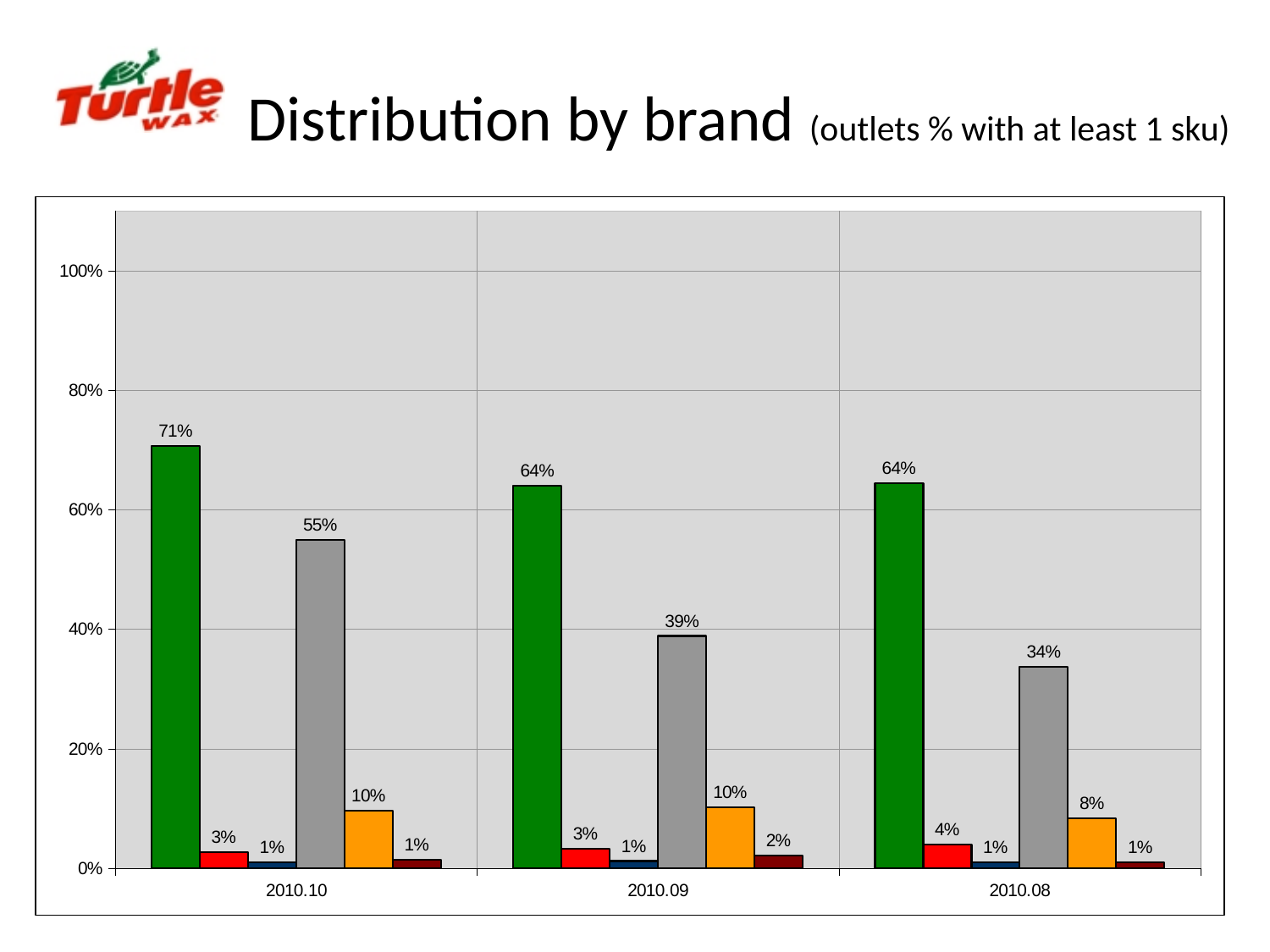
What is the difference between the green bar and the grey bar for 2010.10? 16% What is the value of the orange bar for 2010.08? 8% What is the value of the grey bar for 2010.09? 39% Is the value of the green bar for 2010.08 greater or less than 60%? greater What is the value of the green bar for 2010.10? 71% In which period is the grey bar lowest? 2010.08 Which is larger for 2010.09: the green bar or the grey bar? the green bar How many periods are shown on the x axis? 3 What is the value of the red bar for 2010.08? 4% What is the difference between the grey bar values for 2010.10 and 2010.08? 21% What kind of chart is shown on the slide? bar chart In which period is the grey bar highest? 2010.10